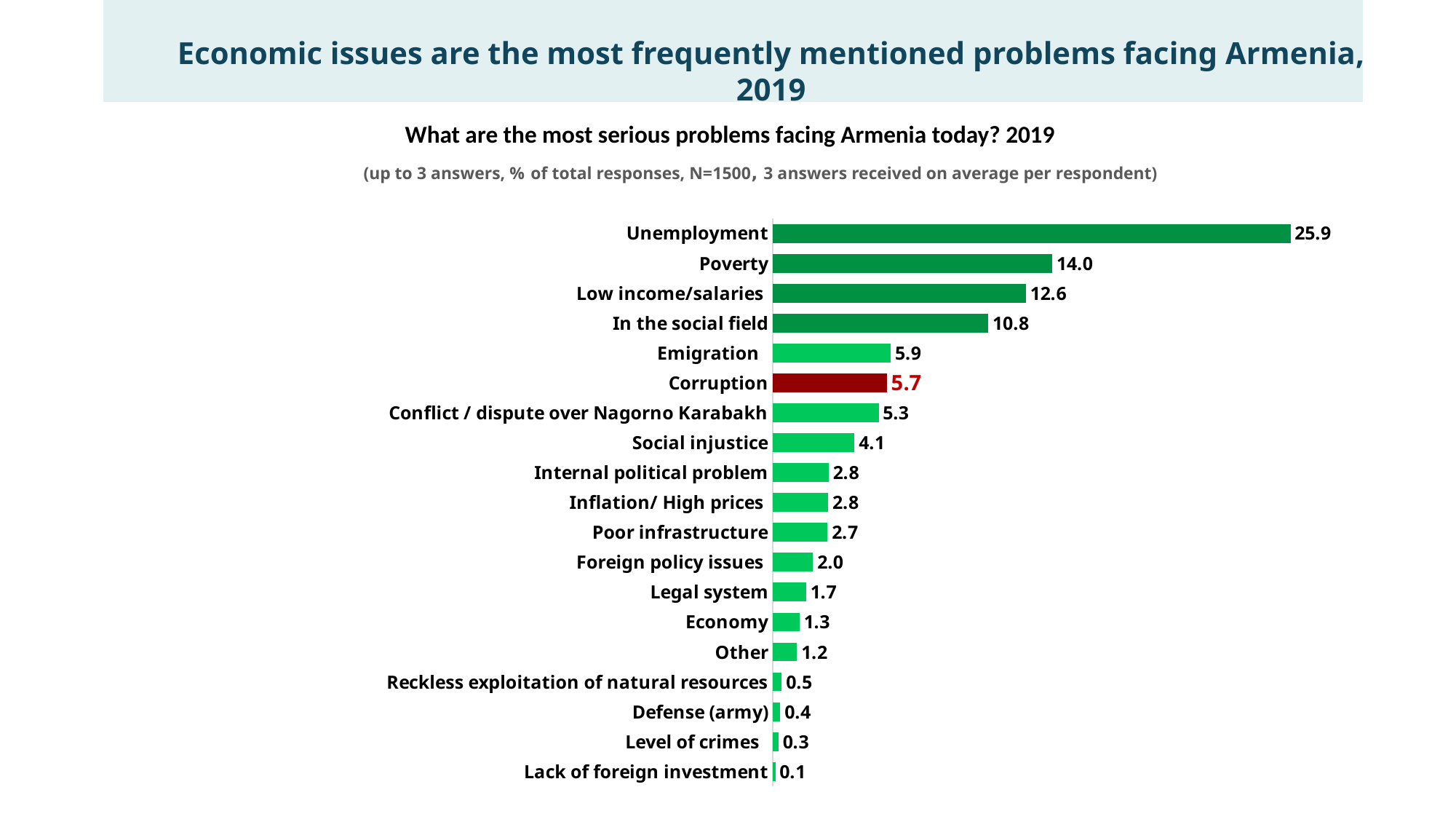
Which category has the lowest value? Lack of foreign investment How many categories are shown in the chart? 19 What kind of chart is shown on the slide? Bar chart Which category has the highest value? Unemployment What is the value for Corruption? 5.7 What is the value for Conflict / dispute over Nagorno Karabakh? 5.3 What is the value for Unemployment? 25.9 What is the difference between the values for Low income/salaries and In the social field? 1.8 Which category's bar is coloured dark red? Corruption What is the difference between the values for Unemployment and Poverty? 11.9 What is the title of the chart? What are the most serious problems facing Armenia today? 2019 Which is larger, the value for Emigration or the value for Social injustice? Emigration